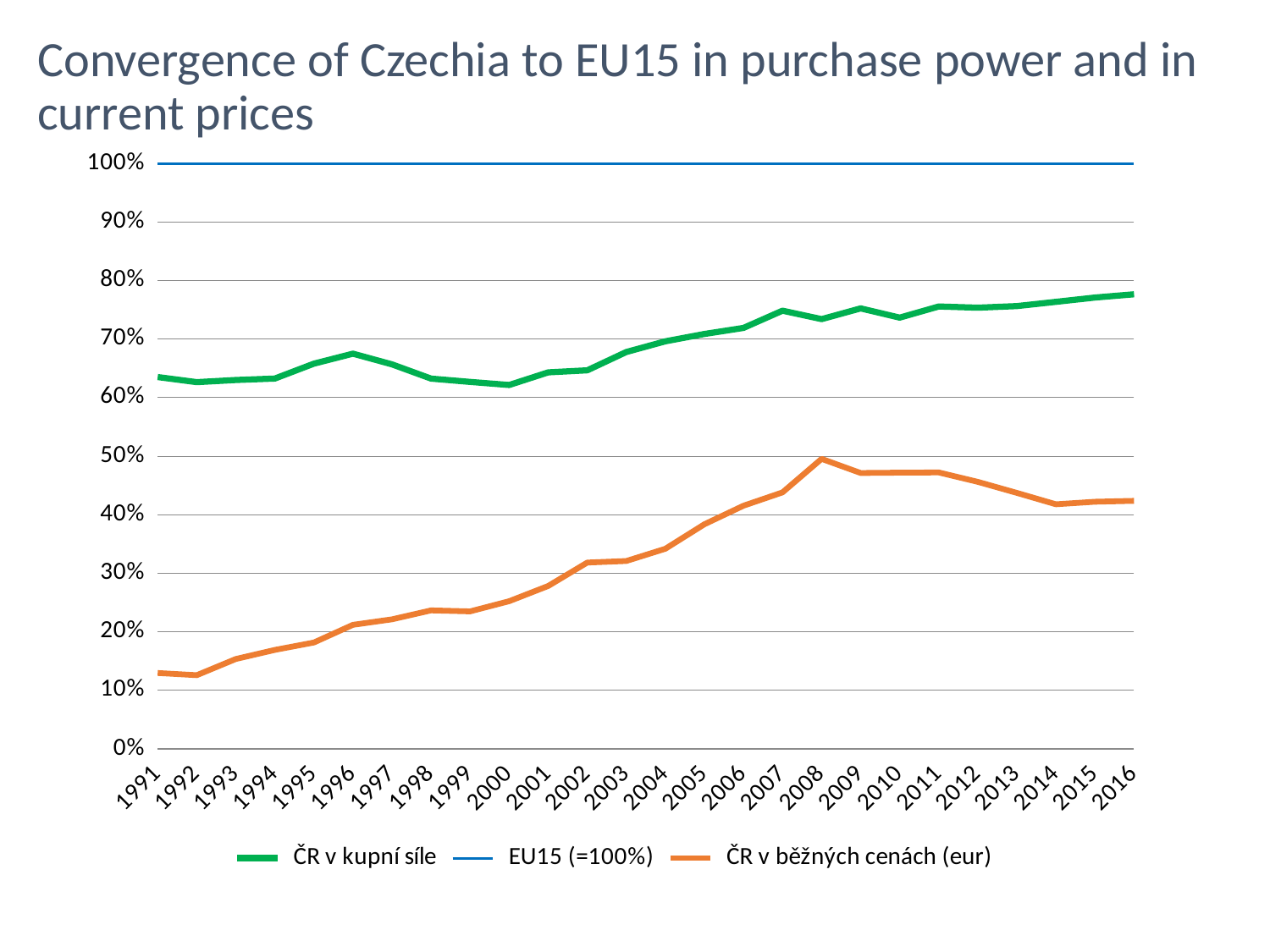
Is the value for ČR v běžných cenách (eur) in 1991 greater or less than 20%? less Does the ČR v běžných cenách (eur) series rise or fall between 1991 and 2008? rise Is the value for ČR v běžných cenách (eur) in 2008 greater or less than 40%? greater Is the value for ČR v kupní síle in 2016 greater or less than 70%? greater What colour is the line for ČR v kupní síle? green What is the value of the EU15 (=100%) series in 2010? 100% In which year is the ČR v běžných cenách (eur) series at its lowest? 1992 In which year does the ČR v běžných cenách (eur) series reach its highest value? 2008 How many series does the legend list? 3 What kind of chart is shown on the slide? line chart How many years are shown on the x axis? 26 Which series is higher in 2005, ČR v kupní síle or ČR v běžných cenách (eur)? ČR v kupní síle